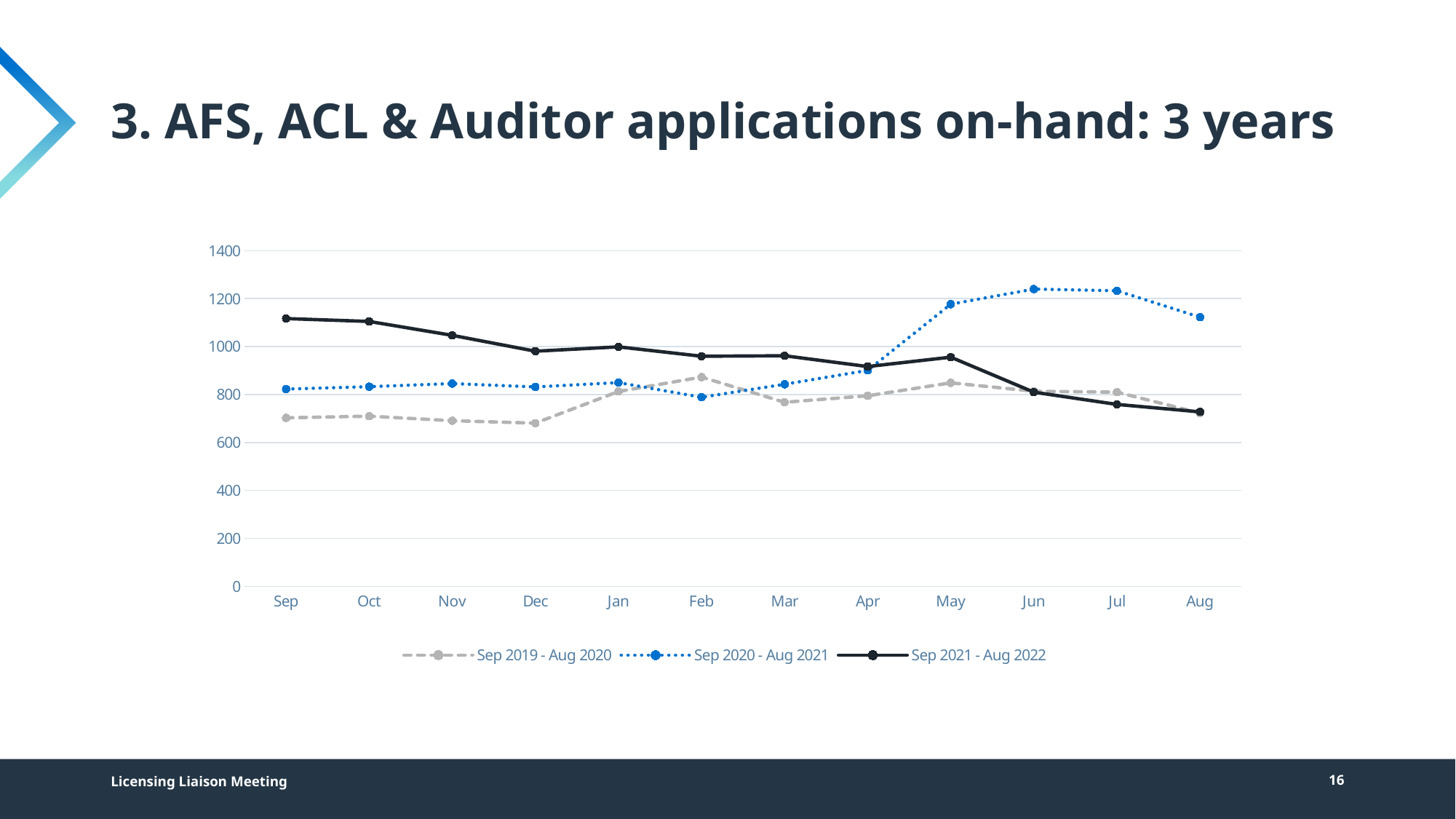
In which month is the Sep 2021 - Aug 2022 series at its lowest? Aug Does the Sep 2021 - Aug 2022 series generally rise or fall from Sep to Aug? Fall In Aug, which series has the higher value: Sep 2020 - Aug 2021 or Sep 2021 - Aug 2022? Sep 2020 - Aug 2021 In Sep, which series has the higher value: Sep 2021 - Aug 2022 or Sep 2019 - Aug 2020? Sep 2021 - Aug 2022 In which month is the Sep 2020 - Aug 2021 series at its lowest? Feb Is the value for Sep 2020 - Aug 2021 in Jun greater or less than 1200? greater Is the value for Sep 2019 - Aug 2020 in Dec greater or less than 800? less What kind of chart is shown on the slide? Line chart Is the value for Sep 2021 - Aug 2022 in Sep greater or less than 1000? greater How many series does the legend list? 3 What is the title of the slide containing the chart? 3. AFS, ACL & Auditor applications on-hand: 3 years How many months are shown along the x axis? 12